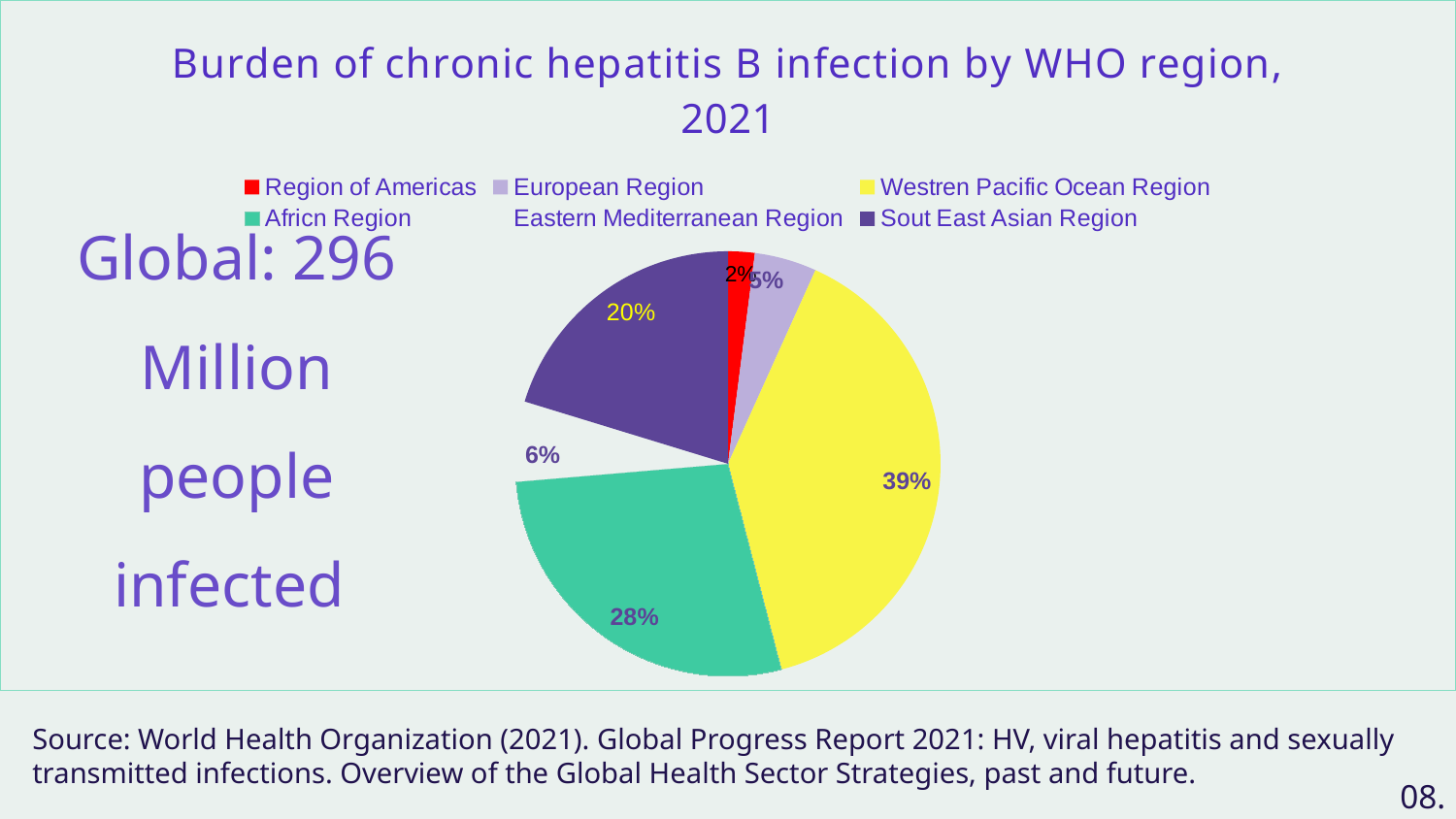
What percentage is shown for the Africn Region? 28% Which has a larger share, the Sout East Asian Region or the Africn Region? Africn Region By how many percentage points does the Westren Pacific Ocean Region exceed the Africn Region? 11 percentage points What percentage is shown for the Region of Americas? 2% How many regions are listed in the chart legend? 6 What percentage is shown for the Sout East Asian Region? 20% What percentage is shown for the Eastern Mediterranean Region? 6% Which region has the smallest slice of the pie? Region of Americas What kind of chart is shown on the slide? Pie chart What share of the pie does the Westren Pacific Ocean Region account for? 39% Which region has the largest slice of the pie? Westren Pacific Ocean Region What percentage is shown for the European Region? 5%